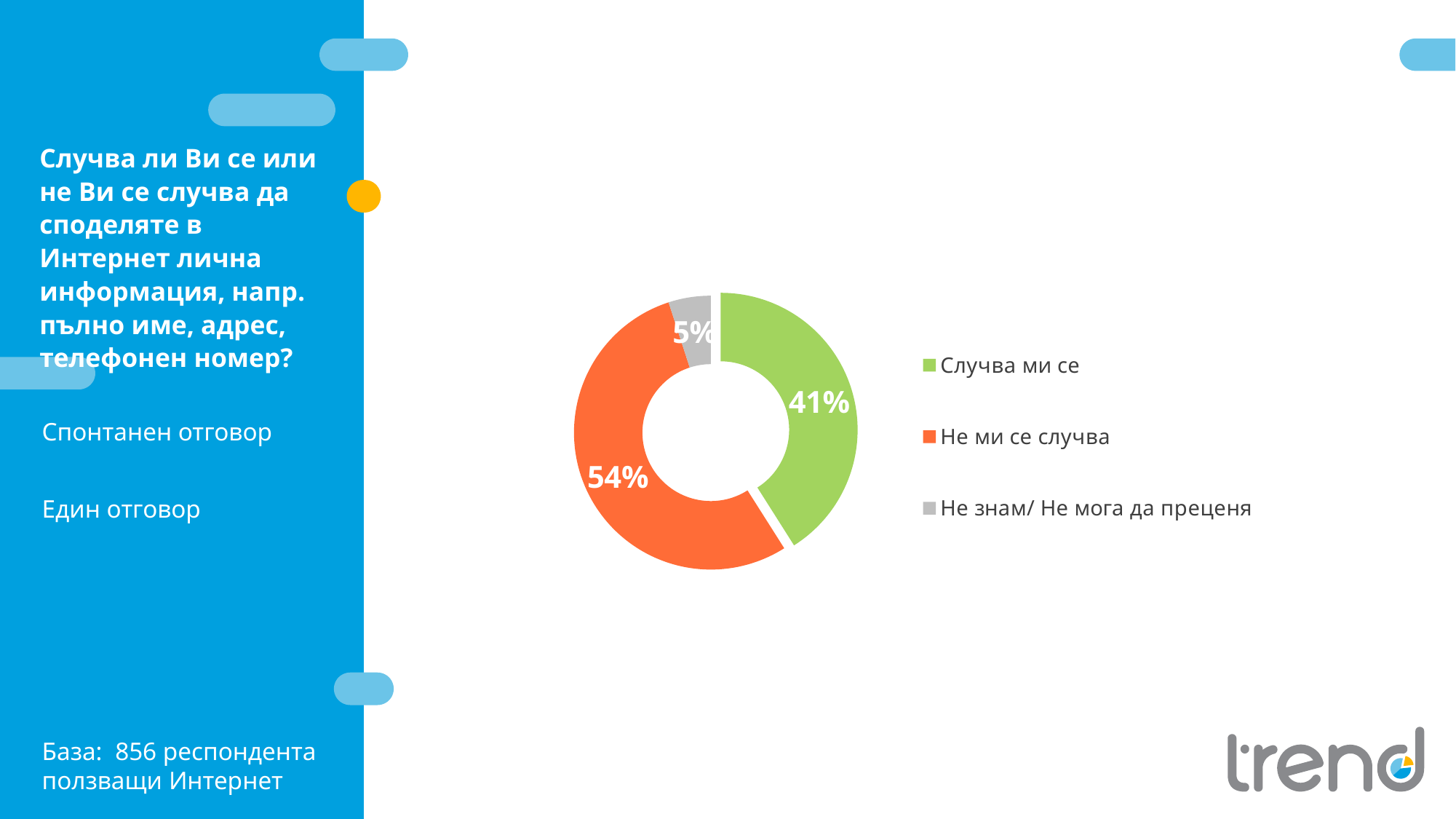
What share of respondents answered "Не знам/ Не мога да преценя"? 5% What share of respondents answered "Случва ми се"? 41% What colour represents "Случва ми се" in the chart? Green Which answer has the largest share? Не ми се случва What kind of chart is shown on the slide? Doughnut (pie) chart Which is larger: the share for "Случва ми се" or for "Не ми се случва"? Не ми се случва How many categories does the chart show? 3 How many respondents form the base of the survey shown on the slide? 856 How many entries does the legend list? 3 What is the difference in percentage points between "Не ми се случва" and "Случва ми се"? 13 percentage points What share of respondents answered "Не ми се случва"? 54% Which answer has the smallest share? Не знам/ Не мога да преценя